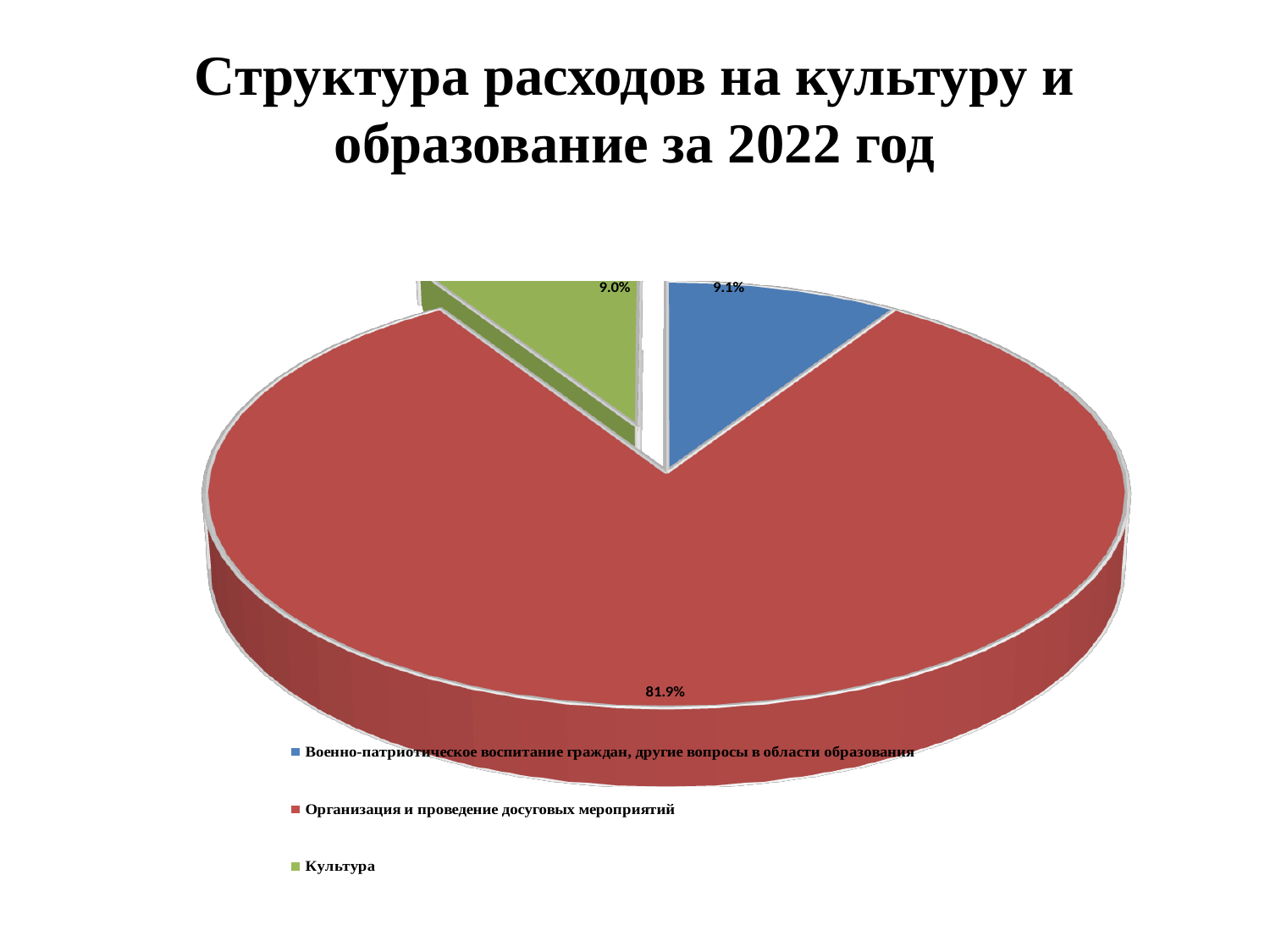
What is the title of the chart? Структура расходов на культуру и образование за 2022 год What share of the pie does "Культура" take? 9.0% What is the difference in percentage points between "Организация и проведение досуговых мероприятий" and "Военно-патриотическое воспитание граждан, другие вопросы в области образования"? 72.8 How many slices does the pie chart have? 3 What is the difference in percentage points between "Организация и проведение досуговых мероприятий" and "Культура"? 72.9 How many entries does the legend list? 3 What kind of chart is shown on the slide? pie chart Which is larger: the slice for "Организация и проведение досуговых мероприятий" or the slice for "Культура"? Организация и проведение досуговых мероприятий What share of the pie does "Военно-патриотическое воспитание граждан, другие вопросы в области образования" take? 9.1% What colour is the slice for "Культура"? green Which category has the largest slice of the pie? Организация и проведение досуговых мероприятий What share of the pie does "Организация и проведение досуговых мероприятий" take? 81.9%